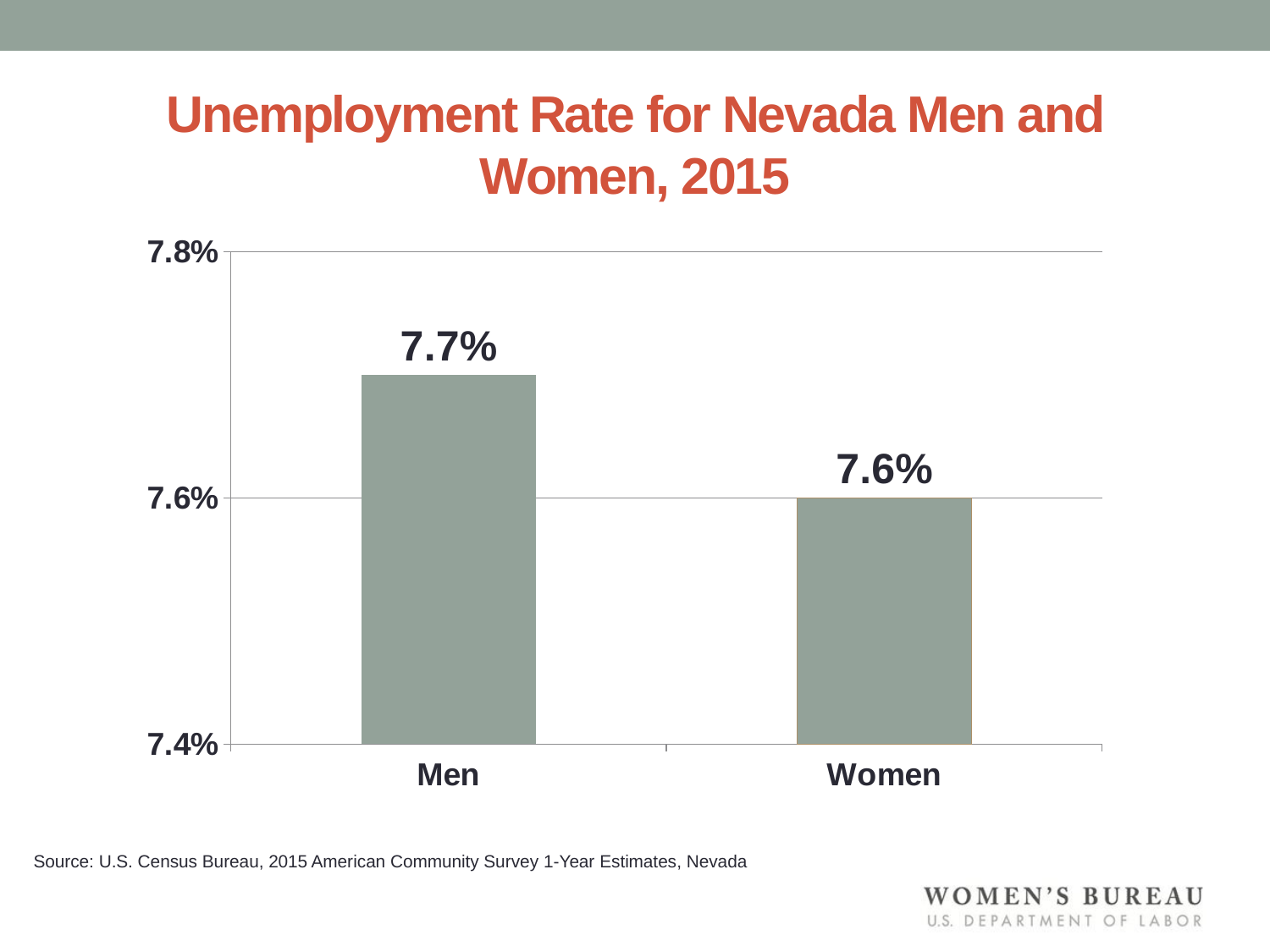
What is the unemployment rate for Men? 7.7% What is the unemployment rate for Women? 7.6% What is the source cited for the chart data? U.S. Census Bureau, 2015 American Community Survey 1-Year Estimates, Nevada Is the unemployment rate for Women greater or less than 7.8%? less Which category has the higher unemployment rate? Men What is the title of the chart? Unemployment Rate for Nevada Men and Women, 2015 Which category has the lower unemployment rate? Women What kind of chart is shown on the slide? Bar chart How many categories are shown on the chart? 2 Is the unemployment rate for Men greater or less than 7.6%? greater What is the difference between the unemployment rate for Men and for Women? 0.1%